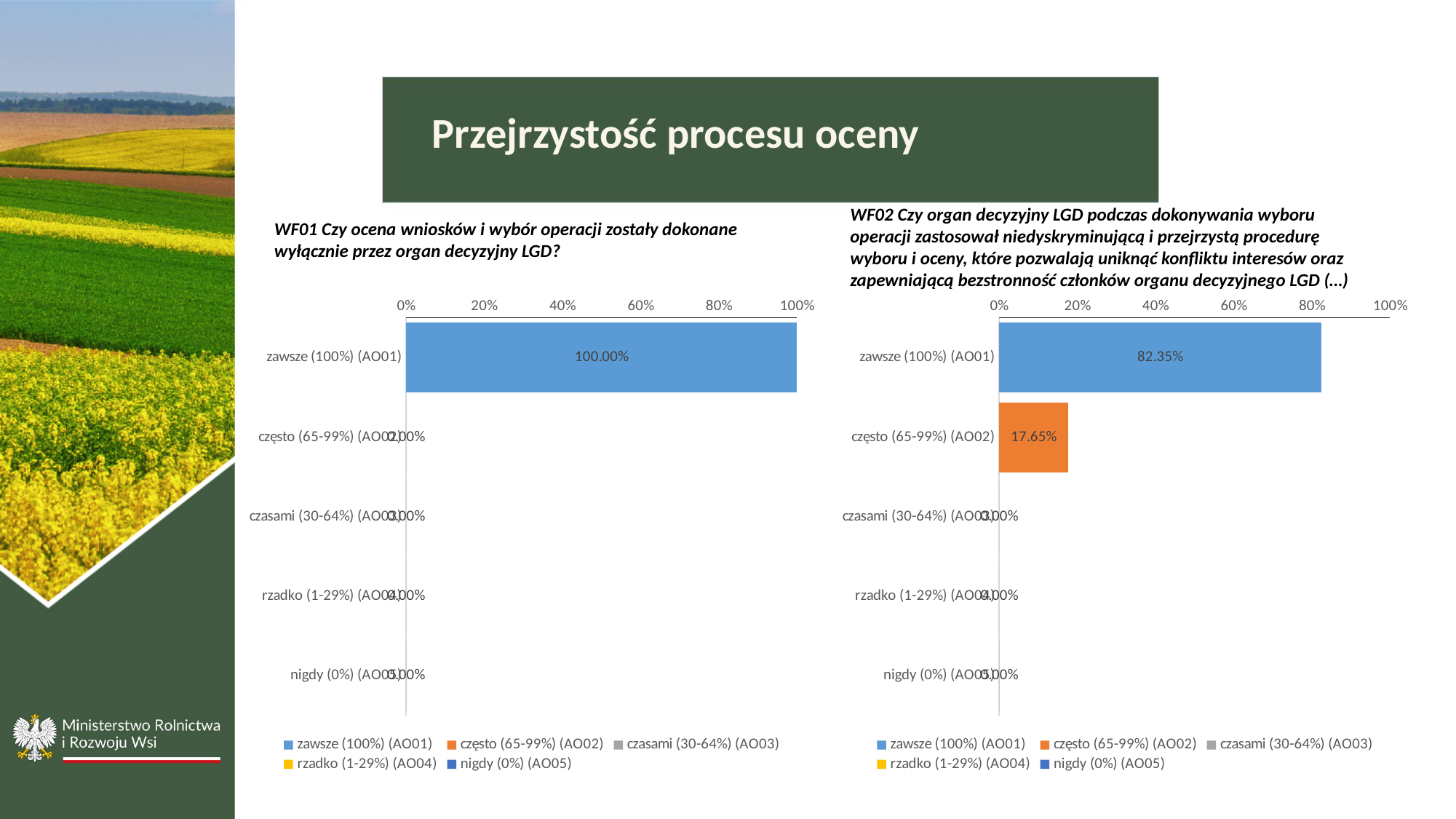
In the WF02 chart on the right, is the value for "zawsze (100%) (AO01)" greater or less than 80%? greater How many series does the legend of the WF02 chart on the right list? 5 How many categories are shown in the WF01 chart on the left? 5 In the WF02 chart on the right, which is larger: the value for "zawsze (100%) (AO01)" or for "często (65-99%) (AO02)"? zawsze (100%) (AO01) In the WF01 chart on the left, what is the value for "zawsze (100%) (AO01)"? 100.00% In the WF02 chart on the right, which category has the highest value? zawsze (100%) (AO01) In the WF02 chart on the right, what is the difference between the values for "zawsze (100%) (AO01)" and "często (65-99%) (AO02)"? 64.70% What kind of chart is the WF01 chart on the left? bar chart In the WF01 chart on the left, what is the value for "często (65-99%) (AO02)"? 0.00% What is the title of the slide? Przejrzystość procesu oceny In the WF02 chart on the right, what is the value for "zawsze (100%) (AO01)"? 82.35% In the WF02 chart on the right, what is the value for "często (65-99%) (AO02)"? 17.65%